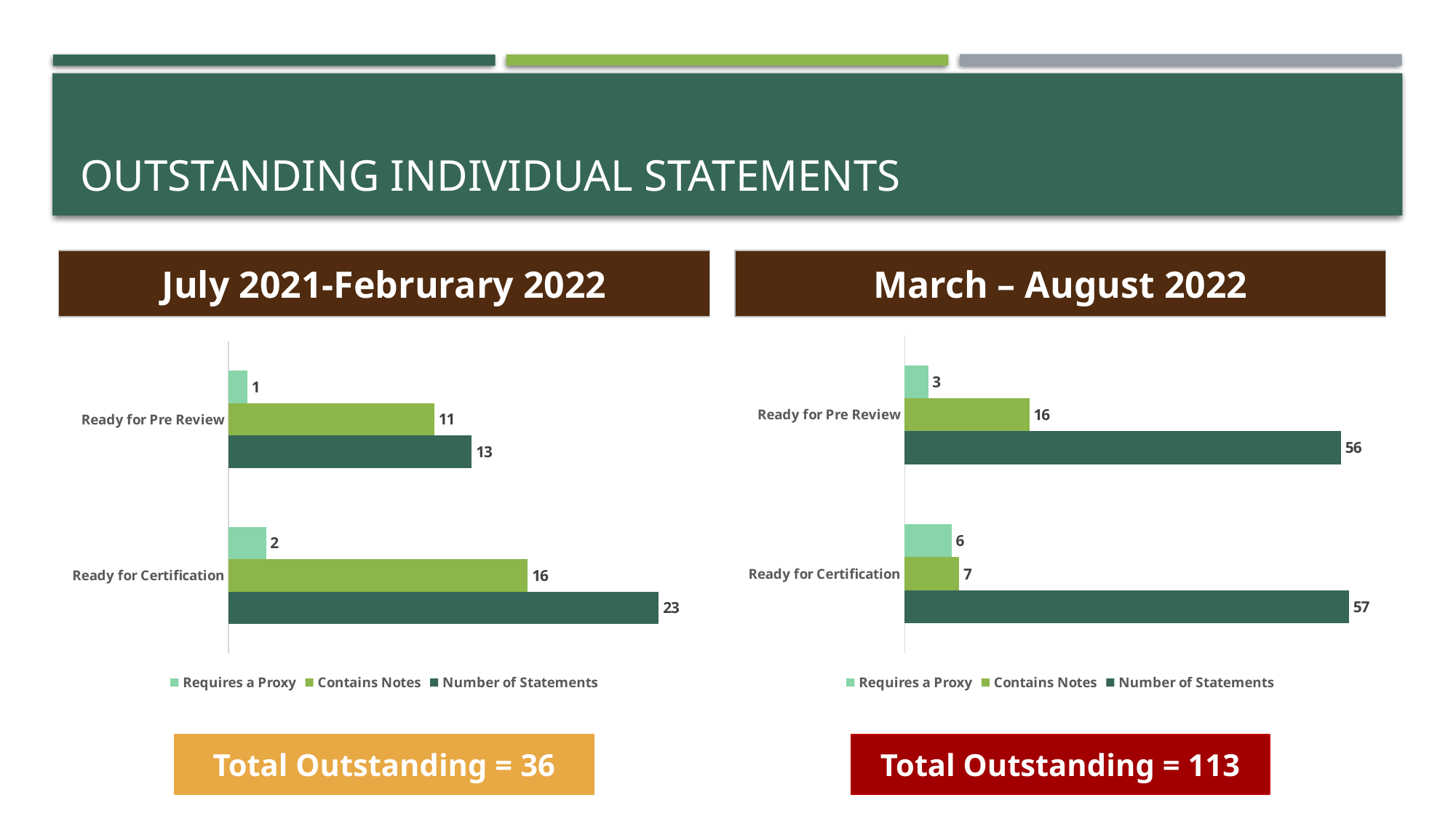
In the March – August 2022 chart, is the Contains Notes value larger for Ready for Pre Review or Ready for Certification? Ready for Pre Review In the March – August 2022 chart, which category has the higher Number of Statements value? Ready for Certification In the March – August 2022 chart, what is the Contains Notes value for Ready for Pre Review? 16 In the July 2021-February 2022 chart, what is the Number of Statements value for Ready for Certification? 23 In the March – August 2022 chart, what is the Requires a Proxy value for Ready for Certification? 6 In the July 2021-February 2022 chart, what is the Contains Notes value for Ready for Pre Review? 11 In the July 2021-February 2022 chart, which series has the lowest value for Ready for Pre Review? Requires a Proxy In the July 2021-February 2022 chart, what is the difference between the Number of Statements values for Ready for Certification and Ready for Pre Review? 10 What type of chart is the March – August 2022 chart? Bar chart How many categories are shown in the March – August 2022 chart? 2 In the March – August 2022 chart, what is the difference between the Contains Notes values for Ready for Pre Review and Ready for Certification? 9 How many series does the legend of the July 2021-February 2022 chart list? 3